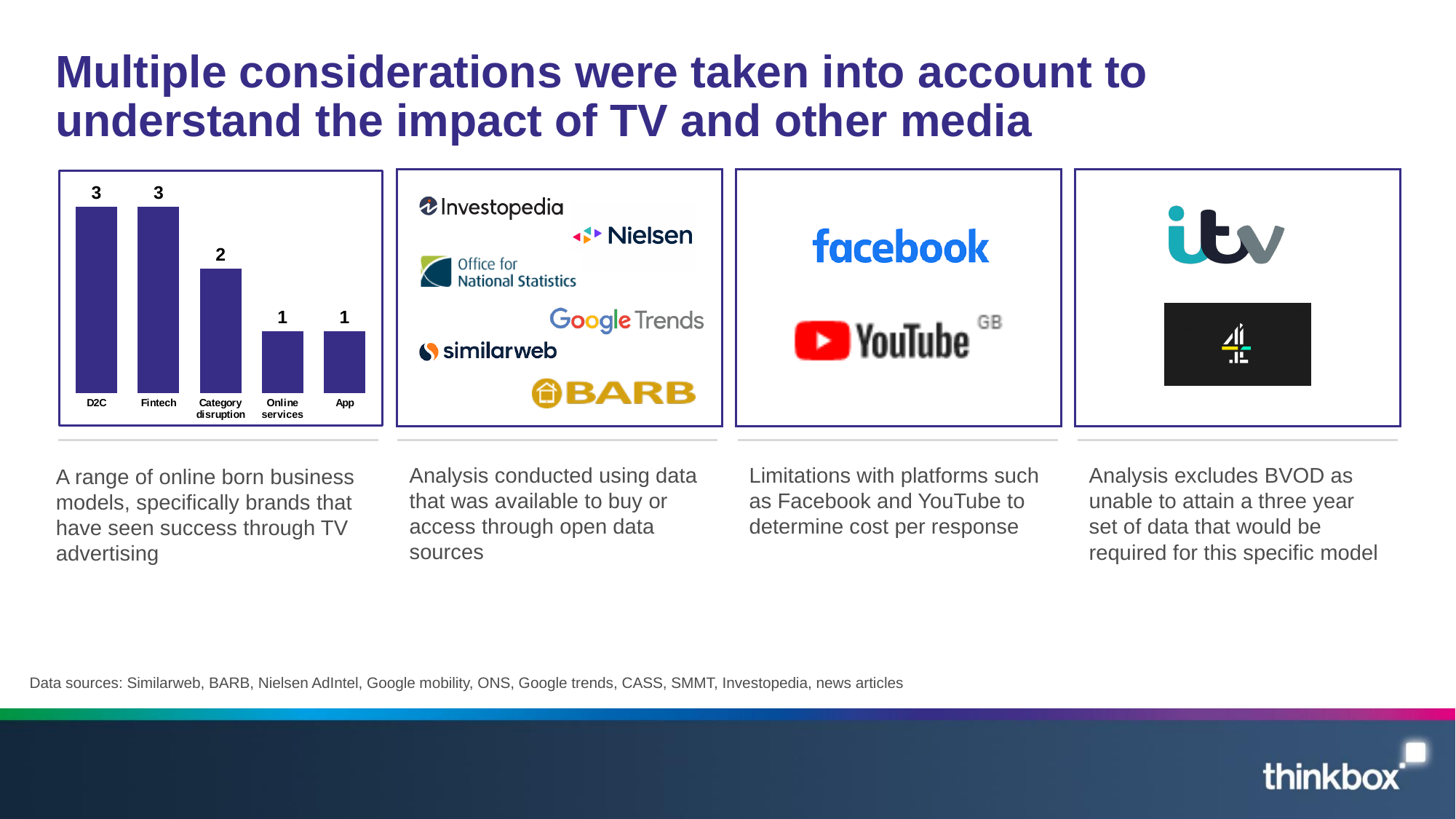
What is the difference between the values for D2C and Category disruption? 1 What kind of chart is shown on the slide? Bar chart What is the value for D2C in the bar chart? 3 Which is larger, the value for Category disruption or the value for Online services? Category disruption What is the value for App in the bar chart? 1 What is the difference between the values for Fintech and App? 2 How many categories are shown in the bar chart? 5 Which categories have the lowest value in the bar chart? Online services and App What is the value for Fintech in the bar chart? 3 Do the values in the bar chart generally rise or fall from left to right? Fall What is the value for Online services in the bar chart? 1 What is the value for Category disruption in the bar chart? 2